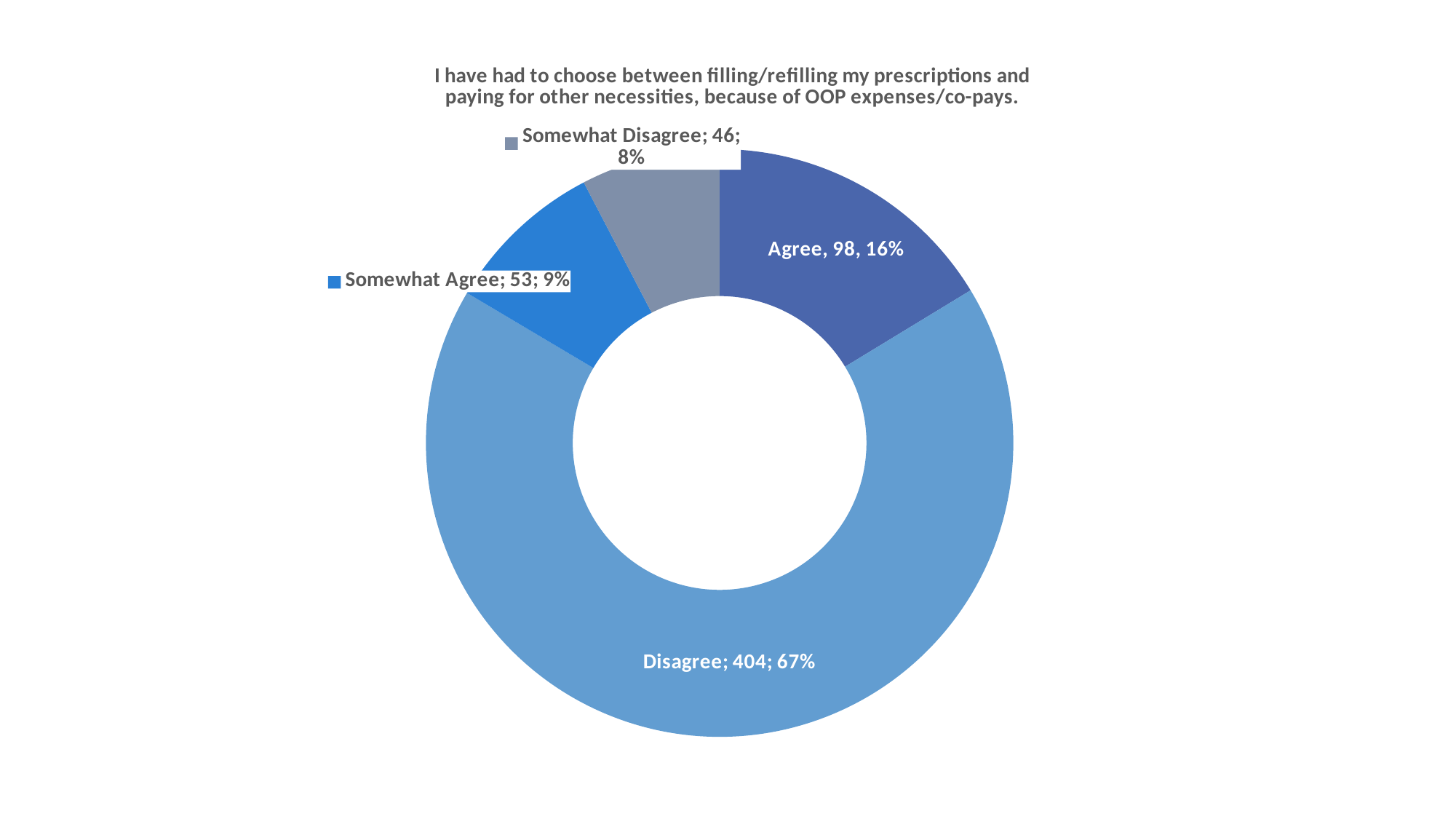
What share of the chart does Somewhat Disagree represent? 8% What is the count for Disagree? 404 What is the count for Agree? 98 How many categories are shown in the chart? 4 What is the count for Somewhat Agree? 53 What is the count for Somewhat Disagree? 46 Which category has the smallest slice? Somewhat Disagree Which category has the largest slice? Disagree Which is larger, the count for Agree or the count for Somewhat Agree? Agree What share of the chart does Agree represent? 16% What kind of chart is shown on the slide? Pie chart (doughnut) What is the difference in count between Disagree and Agree? 306